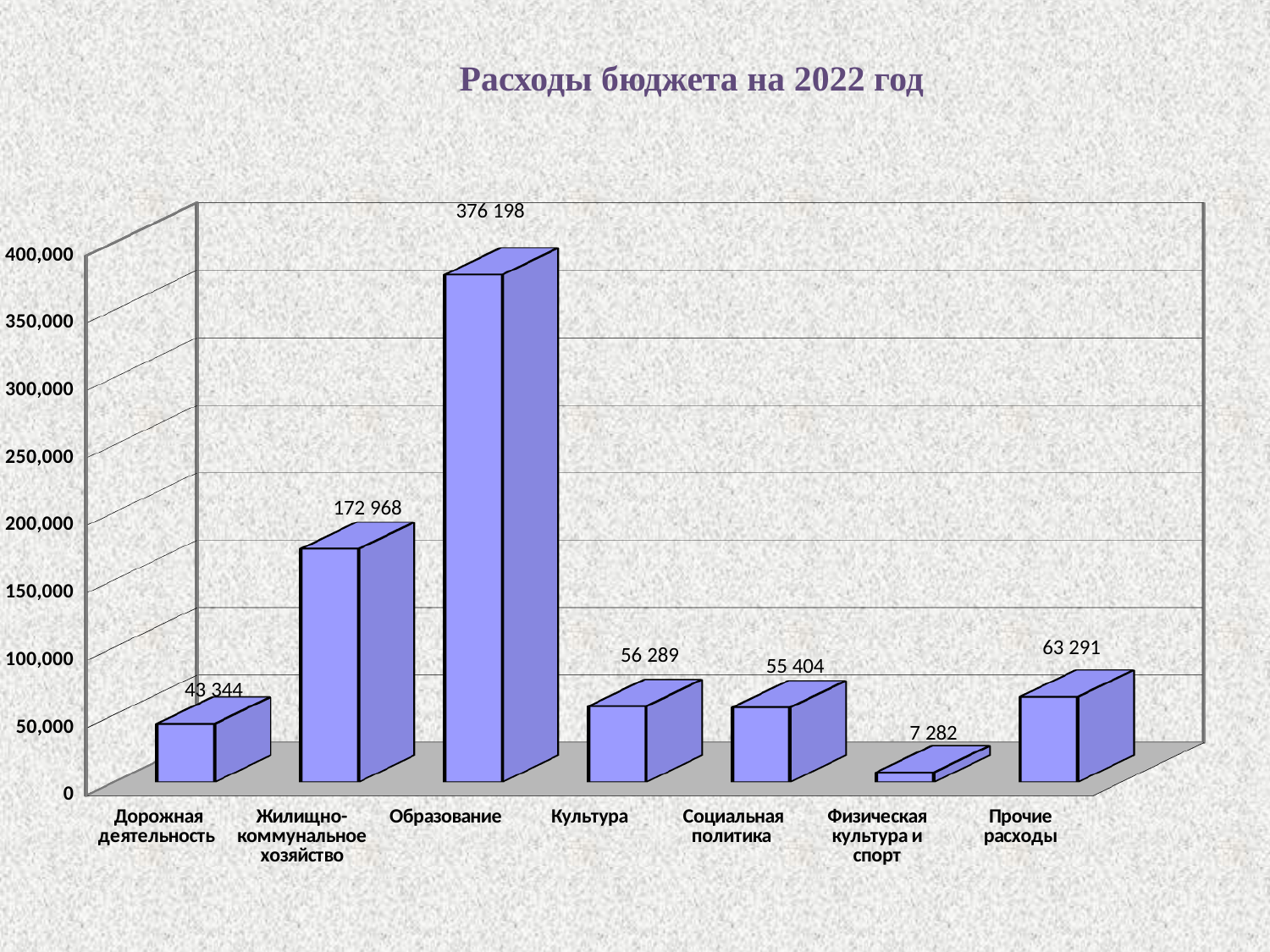
What is the value for Физическая культура и спорт? 7 282 What is the difference between the values for Прочие расходы and Дорожная деятельность? 19 947 What is the difference between the values for Образование and Жилищно-коммунальное хозяйство? 203 230 Which category has the lowest value? Физическая культура и спорт What is the value for Жилищно-коммунальное хозяйство? 172 968 Which category has the highest value? Образование What is the value for Прочие расходы? 63 291 What is the value for Образование? 376 198 What is the title of the chart? Расходы бюджета на 2022 год What kind of chart is this? Bar chart How many categories are shown on the chart? 7 Which is larger, the value for Культура or the value for Социальная политика? Культура